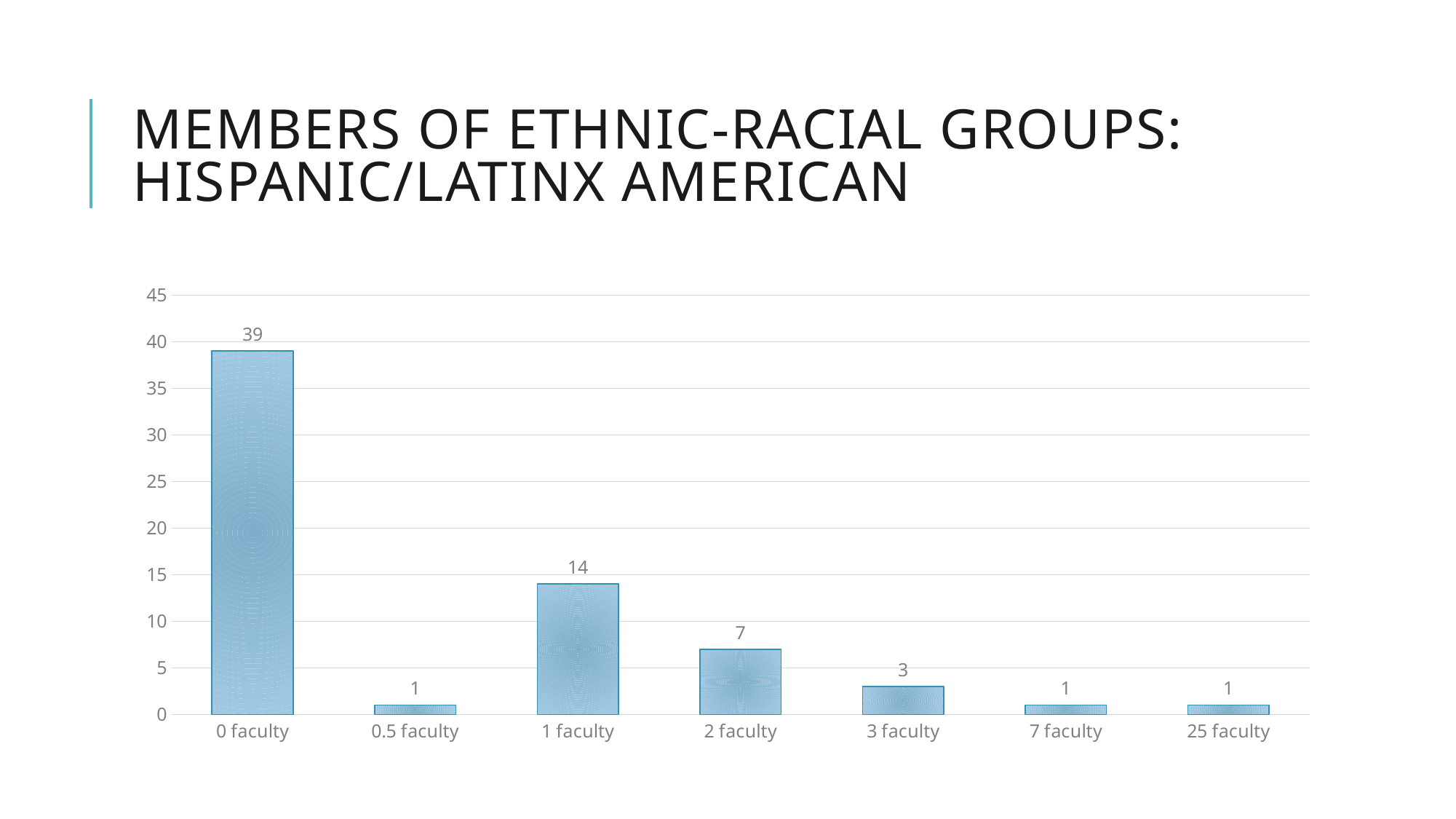
Is the value for "0 faculty" greater or less than 35? greater What is the difference between the values for "0 faculty" and "1 faculty"? 25 What is the difference between the values for "1 faculty" and "2 faculty"? 7 What is the value for the "2 faculty" category? 7 What is the value for the "0 faculty" category? 39 Which category has the highest value? 0 faculty What is the value for the "1 faculty" category? 14 What is the title of the slide containing the chart? Members of Ethnic-Racial Groups: Hispanic/Latinx American What is the value for the "3 faculty" category? 3 How many categories are shown on the x axis? 7 Which is larger, the value for "2 faculty" or the value for "3 faculty"? 2 faculty What kind of chart is shown on the slide? Bar chart